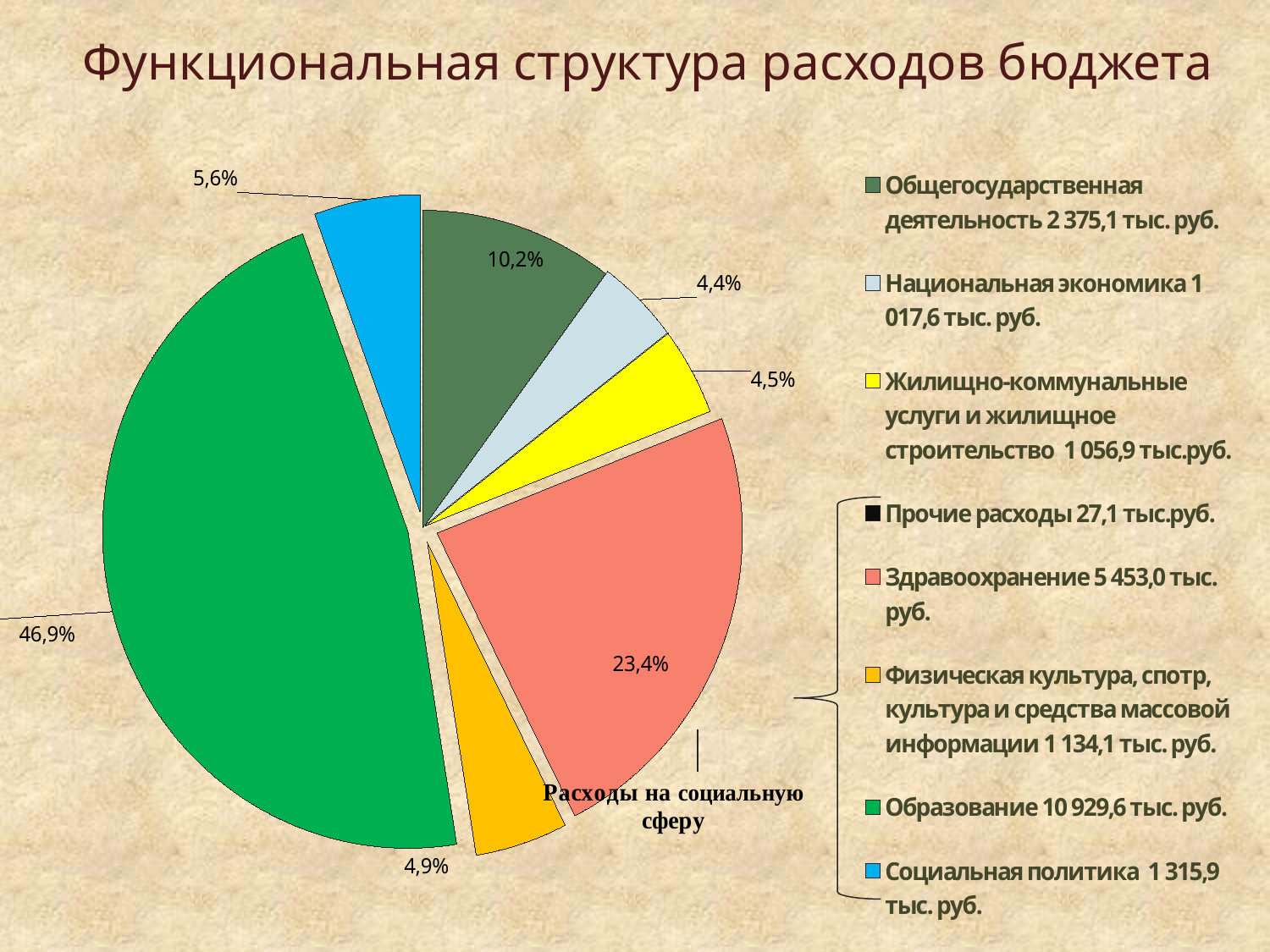
What is the amount shown in the legend for Здравоохранение? 5 453,0 тыс. руб. What share of the pie does Здравоохранение take? 23,4% What share of the pie does Общегосударственная деятельность take? 10,2% What share of the pie does Образование take? 46,9% How many entries does the legend list? 8 Which slice is larger: Общегосударственная деятельность or Социальная политика? Общегосударственная деятельность What is the difference in percentage points between the Образование slice and the Здравоохранение slice? 23,5% Which category has the largest slice of the pie? Образование What is the amount shown in the legend for Образование? 10 929,6 тыс. руб. What kind of chart is shown on the slide? pie chart